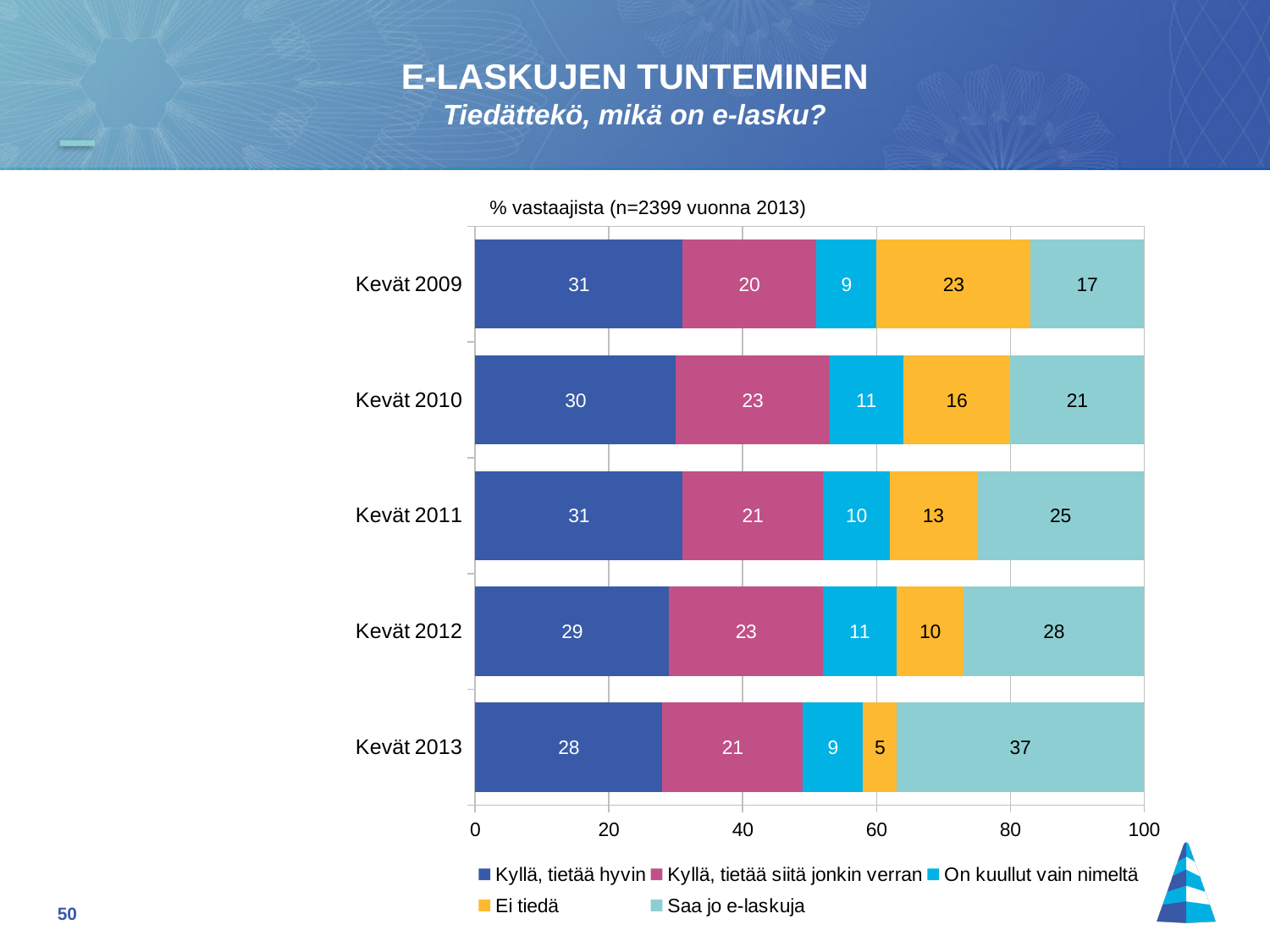
What is the value for "Ei tiedä" in Kevät 2009? 23 Do the "Ei tiedä" values rise or fall from Kevät 2009 to Kevät 2013? Fall What is the value for "Saa jo e-laskuja" in Kevät 2013? 37 Which is larger, the "Kyllä, tietää hyvin" value for Kevät 2009 or for Kevät 2013? Kevät 2009 What kind of chart is shown on the slide? Stacked bar chart What is the value for "On kuullut vain nimeltä" in Kevät 2010? 11 Which year has the highest value for "Saa jo e-laskuja"? Kevät 2013 Which year has the lowest value for "Ei tiedä"? Kevät 2013 How many series does the legend list? 5 How many years (categories) are shown in the chart? 5 What is the total of the stacked bar for Kevät 2009? 100 What is the difference between the "Saa jo e-laskuja" values for Kevät 2013 and Kevät 2009? 20